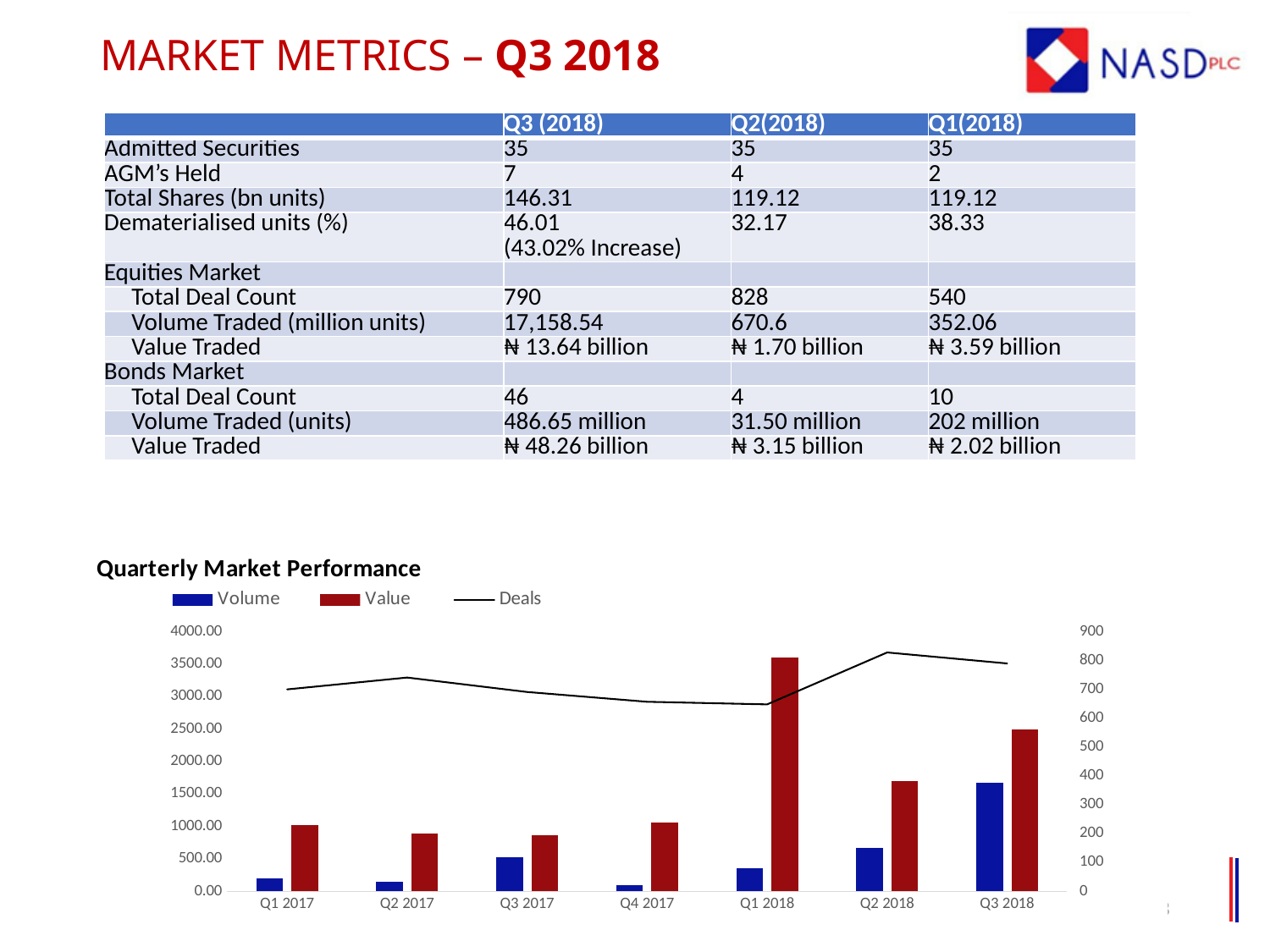
Is the Value for Q1 2018 greater or less than 3000.00? greater In which quarter is the Value bar highest? Q1 2018 What kind of chart is the Quarterly Market Performance chart? Bar chart with a line Which is larger in Q1 2018, the Volume bar or the Value bar? Value What is the title of the chart on the slide? Quarterly Market Performance In which quarter does the Deals line reach its highest point? Q2 2018 In which quarter is the Volume bar lowest? Q4 2017 Which series in the chart is drawn as a line rather than bars? Deals How many quarters are shown on the x axis of the chart? 7 In which quarter is the Volume bar highest? Q3 2018 Is the Volume for Q1 2017 greater or less than 500.00? less How many series does the chart legend list? 3